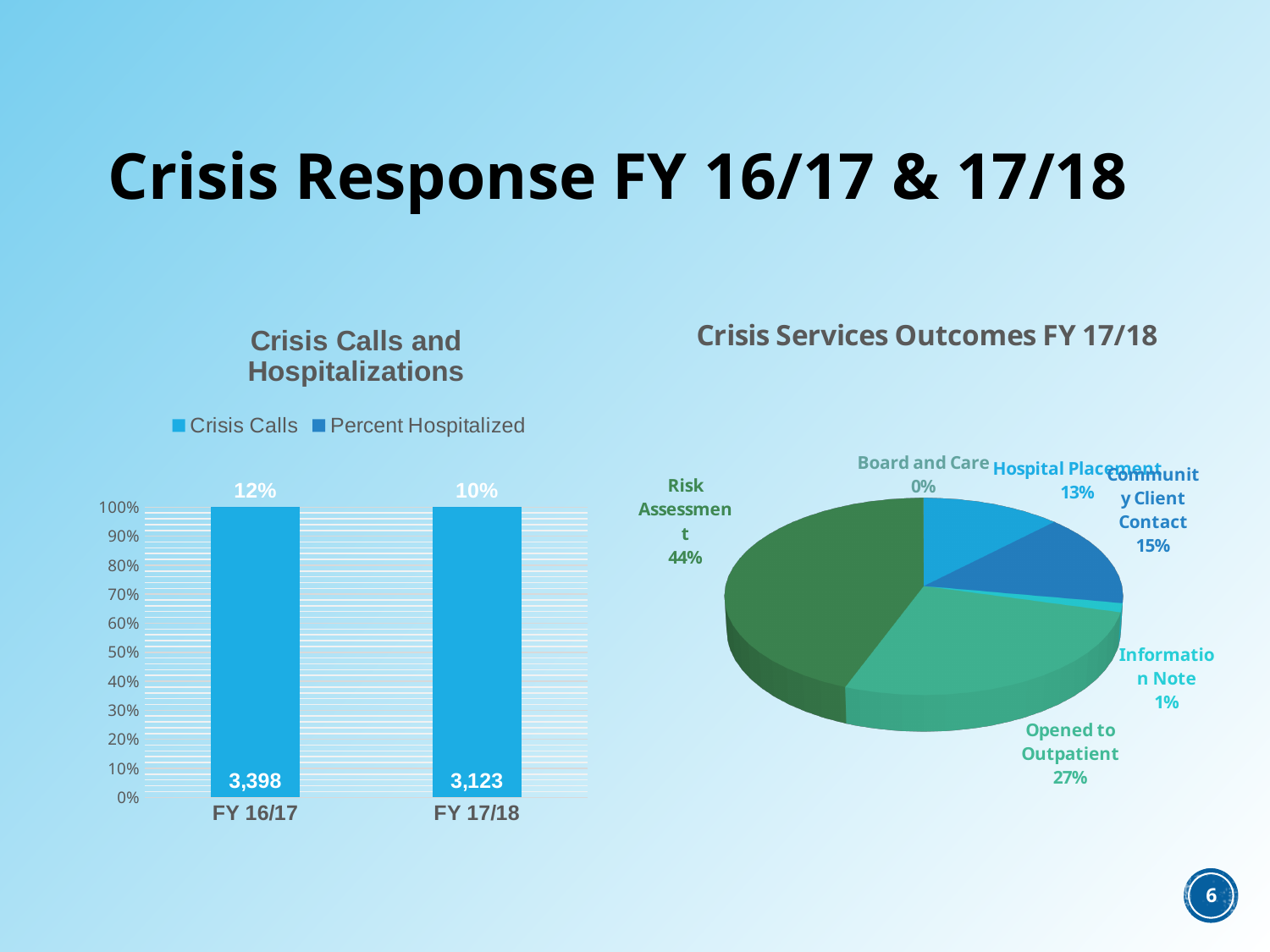
In the 'Crisis Services Outcomes FY 17/18' pie chart, what share does Risk Assessment have? 44% In the 'Crisis Calls and Hospitalizations' chart, what is the Percent Hospitalized for FY 16/17? 12% In the 'Crisis Calls and Hospitalizations' chart, what is the difference in Crisis Calls between FY 16/17 and FY 17/18? 275 In the 'Crisis Services Outcomes FY 17/18' pie chart, which is larger: Hospital Placement or Community Client Contact? Community Client Contact In the 'Crisis Calls and Hospitalizations' chart, what is the number of Crisis Calls for FY 17/18? 3,123 In the 'Crisis Calls and Hospitalizations' chart, what is the Percent Hospitalized for FY 17/18? 10% How many categories are labeled in the 'Crisis Services Outcomes FY 17/18' pie chart? 6 What kind of chart is 'Crisis Calls and Hospitalizations'? Bar chart In the 'Crisis Services Outcomes FY 17/18' pie chart, which category has the largest share? Risk Assessment In the 'Crisis Calls and Hospitalizations' chart, how many series does the legend list? 2 In the 'Crisis Calls and Hospitalizations' chart, what is the number of Crisis Calls for FY 16/17? 3,398 In the 'Crisis Services Outcomes FY 17/18' pie chart, what share does Opened to Outpatient have? 27%